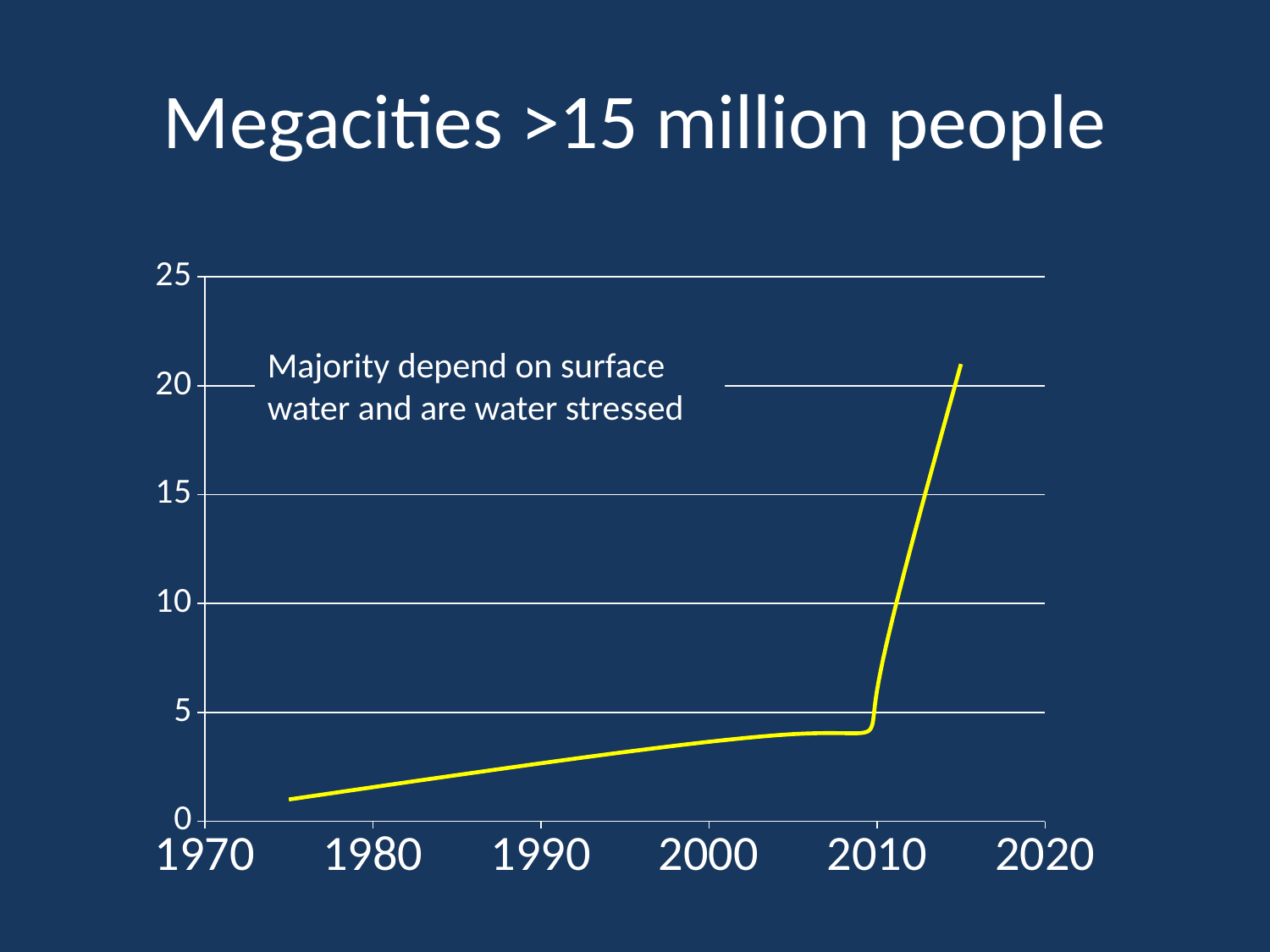
Do the values rise or fall along the x axis from 1970 to 2020? rise Is the value at the right-hand end of the line (around 2015) greater or less than 15? greater What does the annotation text inside the chart say? Majority depend on surface water and are water stressed Is the value for 2000 greater or less than 10? less What kind of chart is shown on the slide? line chart What is the highest value shown on the y axis? 25 What is the title of the chart? Megacities >15 million people Is the value at the left-hand start of the line greater or less than 5? less Which is larger, the value for 2010 or the value for 1980? 2010 Which is larger, the value at the end of the line (around 2015) or the value for 2010? around 2015